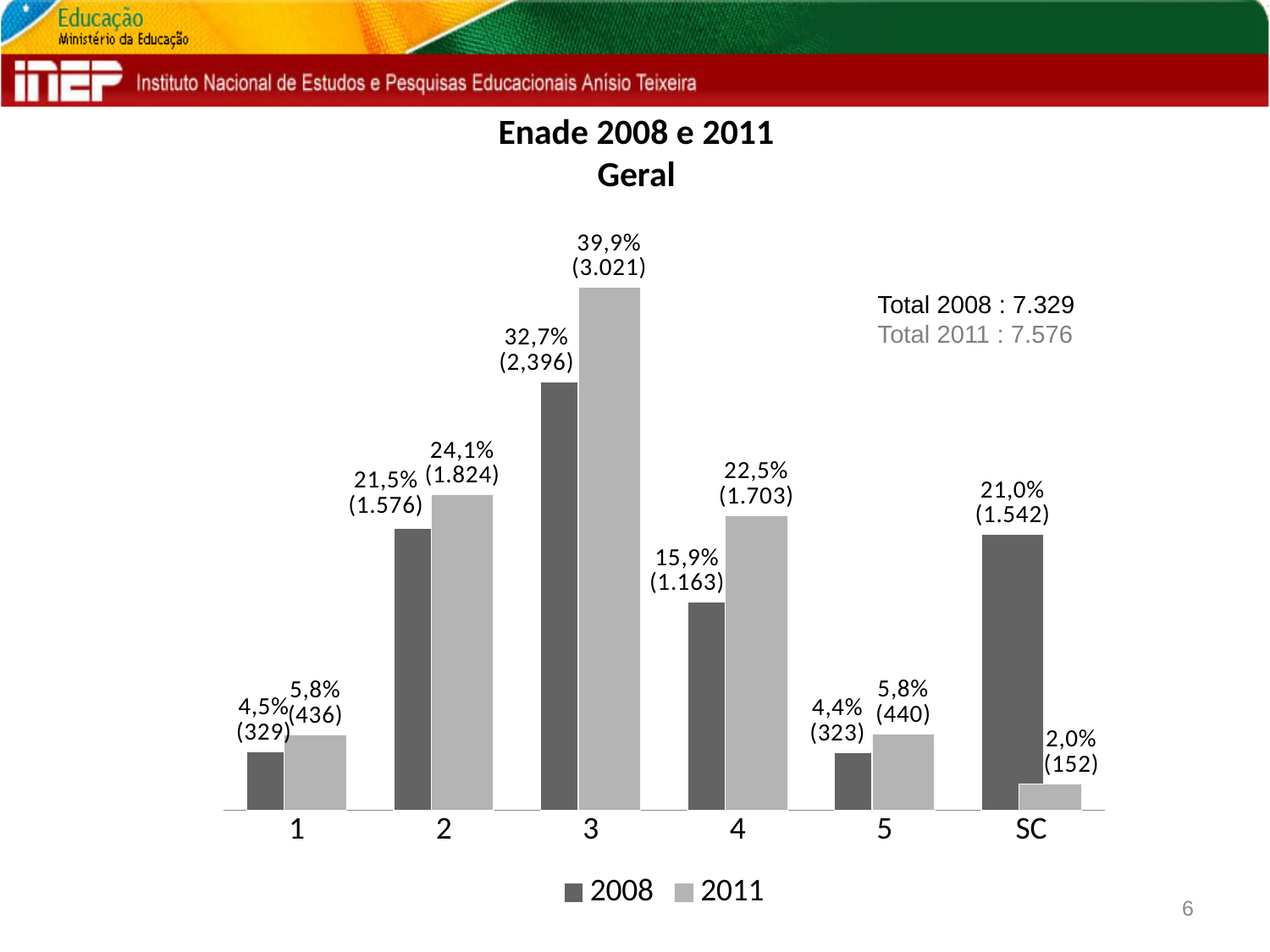
Which category has the highest value in the 2008 series? 3 What is the difference in percentage points between the 2011 and 2008 values for category 4? 6,6 What is the percentage for category 3 in the 2011 series? 39,9% What is the total for 2011 stated on the slide? 7.576 What is the title of the chart? Enade 2008 e 2011 Geral What type of chart is shown on the slide? bar chart Which category has the lowest value in the 2011 series? SC What is the percentage for SC in the 2011 series? 2,0% What is the count shown in parentheses for category 2 in the 2008 series? 1.576 How many series does the legend list? 2 For SC, which series has the larger value, 2008 or 2011? 2008 How many categories are shown on the x axis? 6